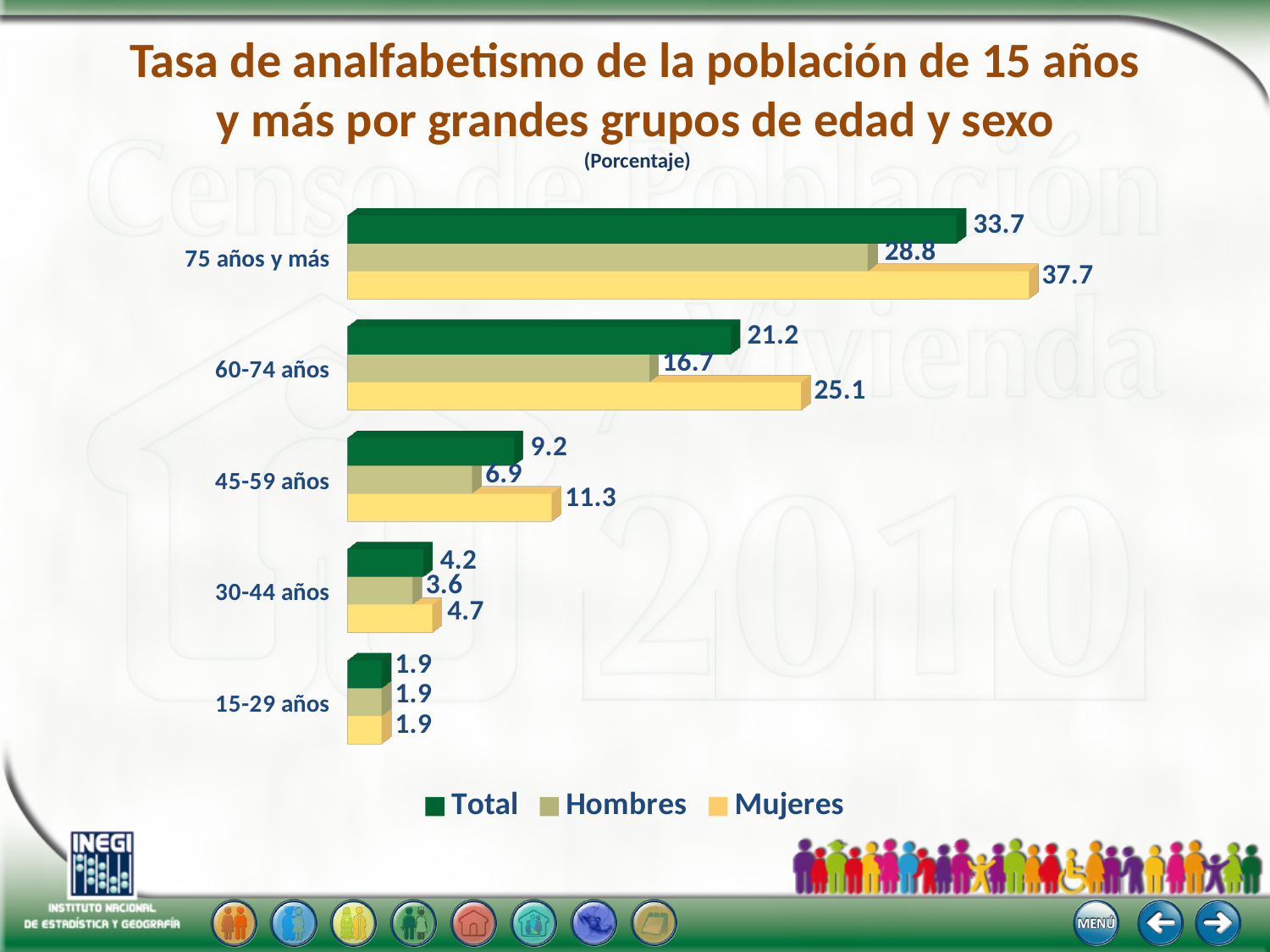
What is the Hombres value for the 60-74 años age group? 16.7 How many series does the legend list? 3 What is the difference between the Mujeres and Hombres values for the 75 años y más age group? 8.9 Which age group has the highest Total value? 75 años y más What is the Total value for the 45-59 años age group? 9.2 Which series is shown in dark green in the legend? Total Which age group has the lowest Mujeres value? 15-29 años How many age groups are shown in the chart? 5 What kind of chart is shown on the slide? Bar chart Which is larger for the 60-74 años age group, the Total value or the Mujeres value? Mujeres What is the Mujeres value for the 75 años y más age group? 37.7 Do the Total values rise or fall as the age groups get older? Rise